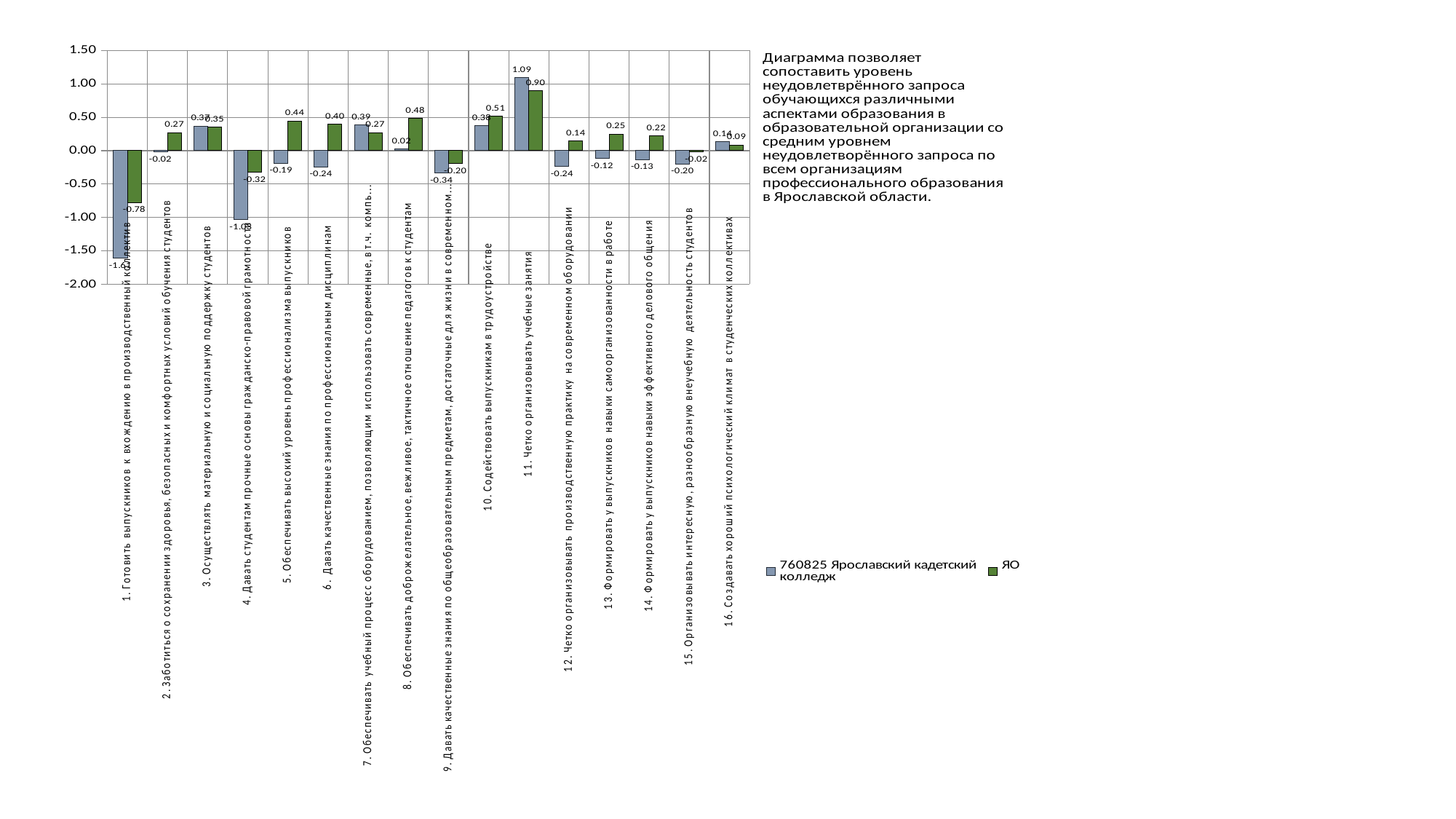
How many categories are plotted along the x axis? 16 What is the value of the ЯО series for category 8 (Обеспечивать доброжелательное, вежливое, тактичное отношение педагогов к студентам)? 0.48 For which category is the ЯО series lowest? 1. Готовить выпускников к вхождению в производственный коллектив How many series does the legend list? 2 For which category is the ЯО series highest? 11. Четко организовывать учебные занятия What is the value of the 760825 Ярославский кадетский колледж series for category 11 (Четко организовывать учебные занятия)? 1.09 What is the value of the 760825 Ярославский кадетский колледж series for category 9 (Давать качественные знания по общеобразовательным предметам)? -0.34 What is the value of the ЯО series for category 11 (Четко организовывать учебные занятия)? 0.90 For category 10 (Содействовать выпускникам в трудоустройстве), which series has the larger value? ЯО What is the difference between the ЯО value and the 760825 Ярославский кадетский колледж value for category 5 (Обеспечивать высокий уровень профессионализма выпускников)? 0.63 What type of chart is shown on the slide? bar chart Is the value of the 760825 Ярославский кадетский колледж series for category 1 greater or less than -1.00? less